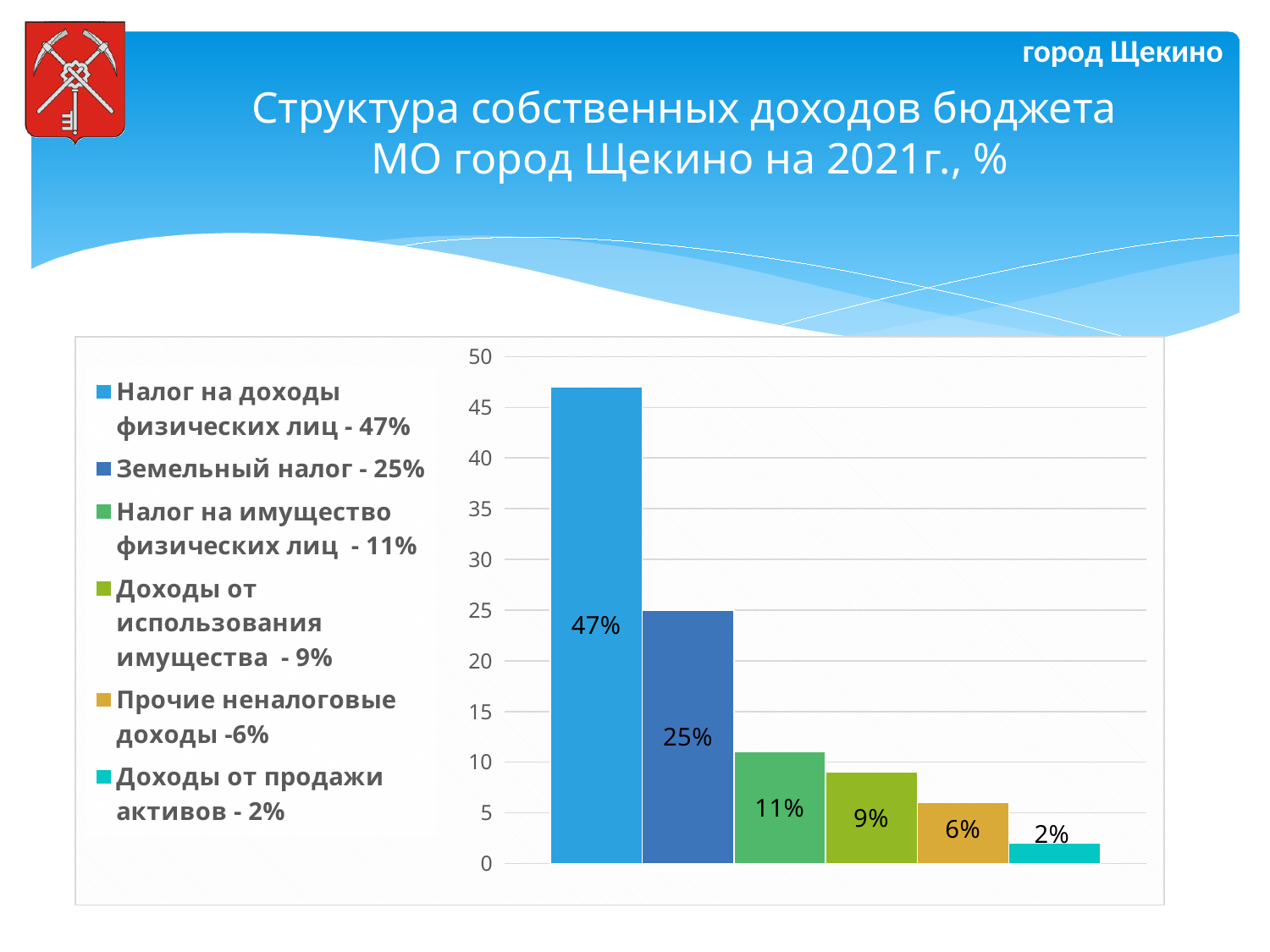
How many series does the legend list? 6 Do the bar values rise or fall from left to right? Fall What is the value for Налог на доходы физических лиц? 47% What kind of chart is shown on the slide? Bar chart What is the value for Земельный налог? 25% What is the difference between Налог на доходы физических лиц and Земельный налог? 22% What is the title of the chart? Структура собственных доходов бюджета МО город Щекино на 2021г., % Which series has the lowest value? Доходы от продажи активов Which is larger, Налог на имущество физических лиц or Прочие неналоговые доходы? Налог на имущество физических лиц What is the value for Доходы от продажи активов? 2% Which series has the highest value? Налог на доходы физических лиц What is the value for Доходы от использования имущества? 9%